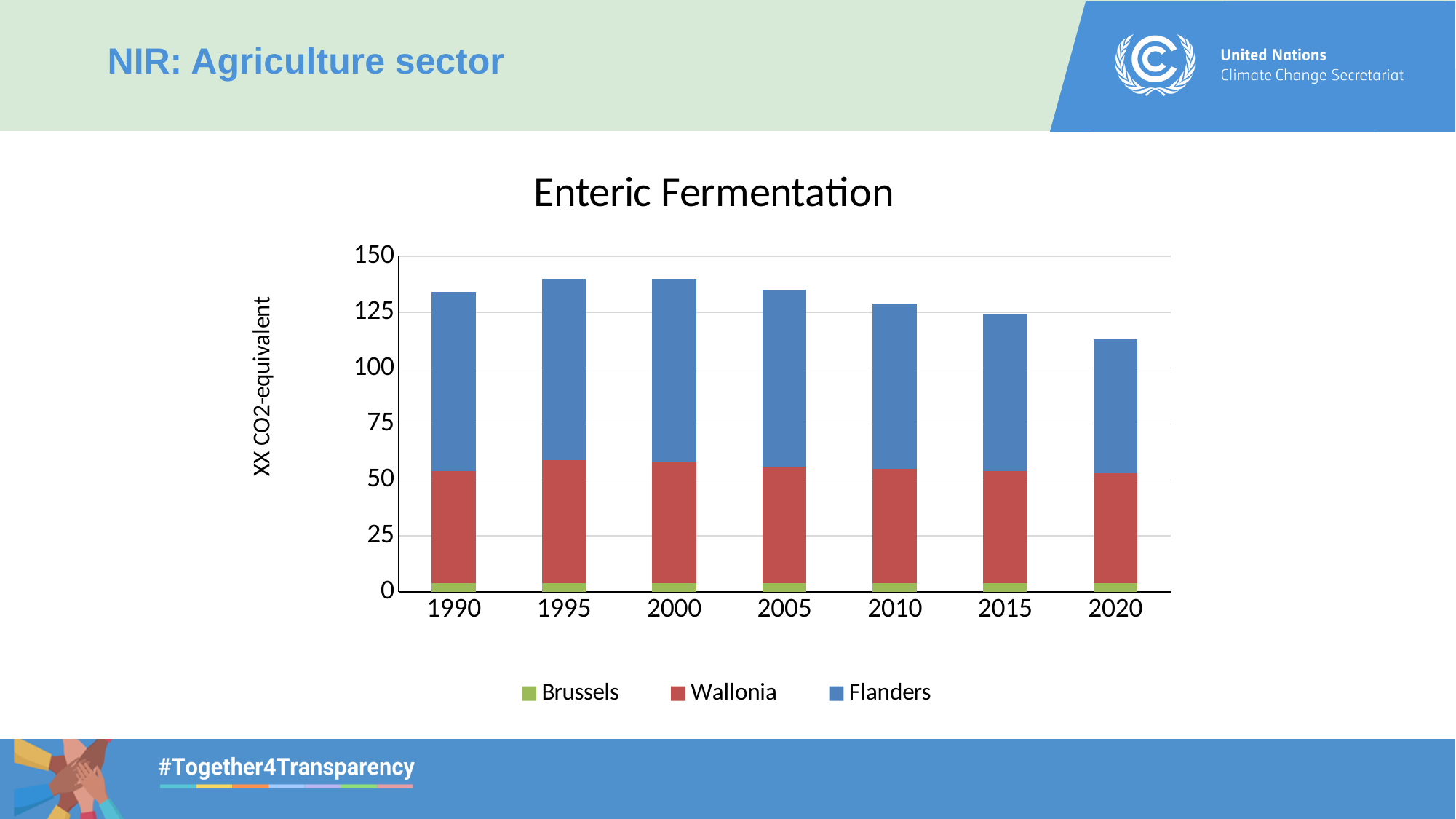
What is the title of the chart? Enteric Fermentation Is the total bar for 1995 greater or less than 125? greater Is the total bar for 2020 greater or less than 125? less Which year has the lowest total bar? 2020 How many years are shown on the x axis? 7 Is the total bar for 2005 larger or smaller than the total bar for 2015? larger Is the total bar for 2010 greater or less than 100? greater What kind of chart is shown on the slide? Stacked bar chart Do the total bars rise or fall from 2000 to 2020? fall Is the total bar for 1990 larger or smaller than the total bar for 2020? larger How many series does the legend list? 3 Which regions are listed in the chart legend? Brussels, Wallonia, Flanders